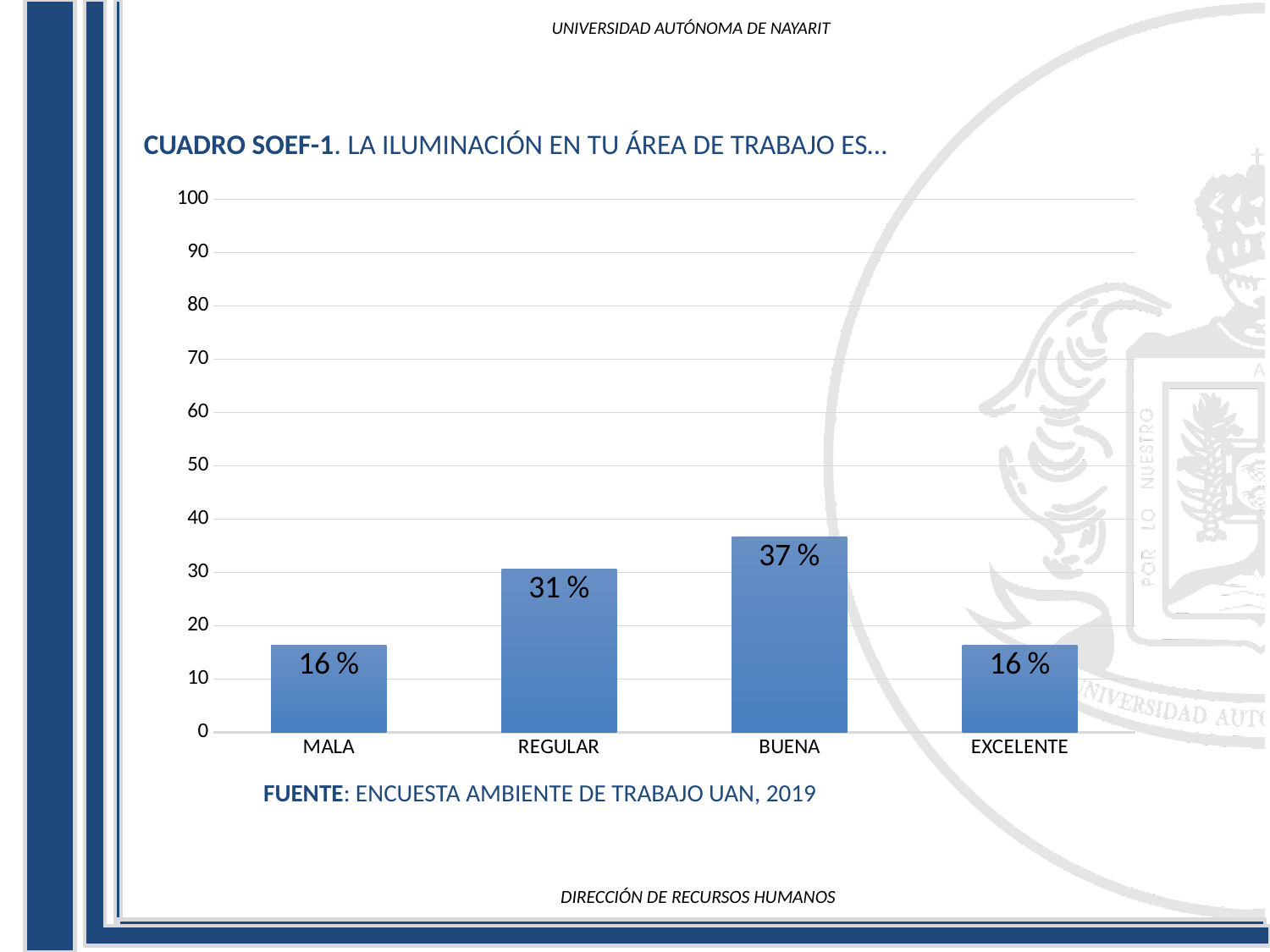
What is the difference between the values for REGULAR and MALA? 15 % Which category has the highest value? BUENA What source is cited below the chart? ENCUESTA AMBIENTE DE TRABAJO UAN, 2019 What is the difference between the values for BUENA and REGULAR? 6 % How many categories are shown on the x axis? 4 What is the value for EXCELENTE? 16 % What kind of chart is shown on the slide? bar chart What is the value for REGULAR? 31 % What is the value for MALA? 16 % Is the value for BUENA greater or less than 40? less What is the value for BUENA? 37 % Which is larger, the value for REGULAR or the value for EXCELENTE? REGULAR